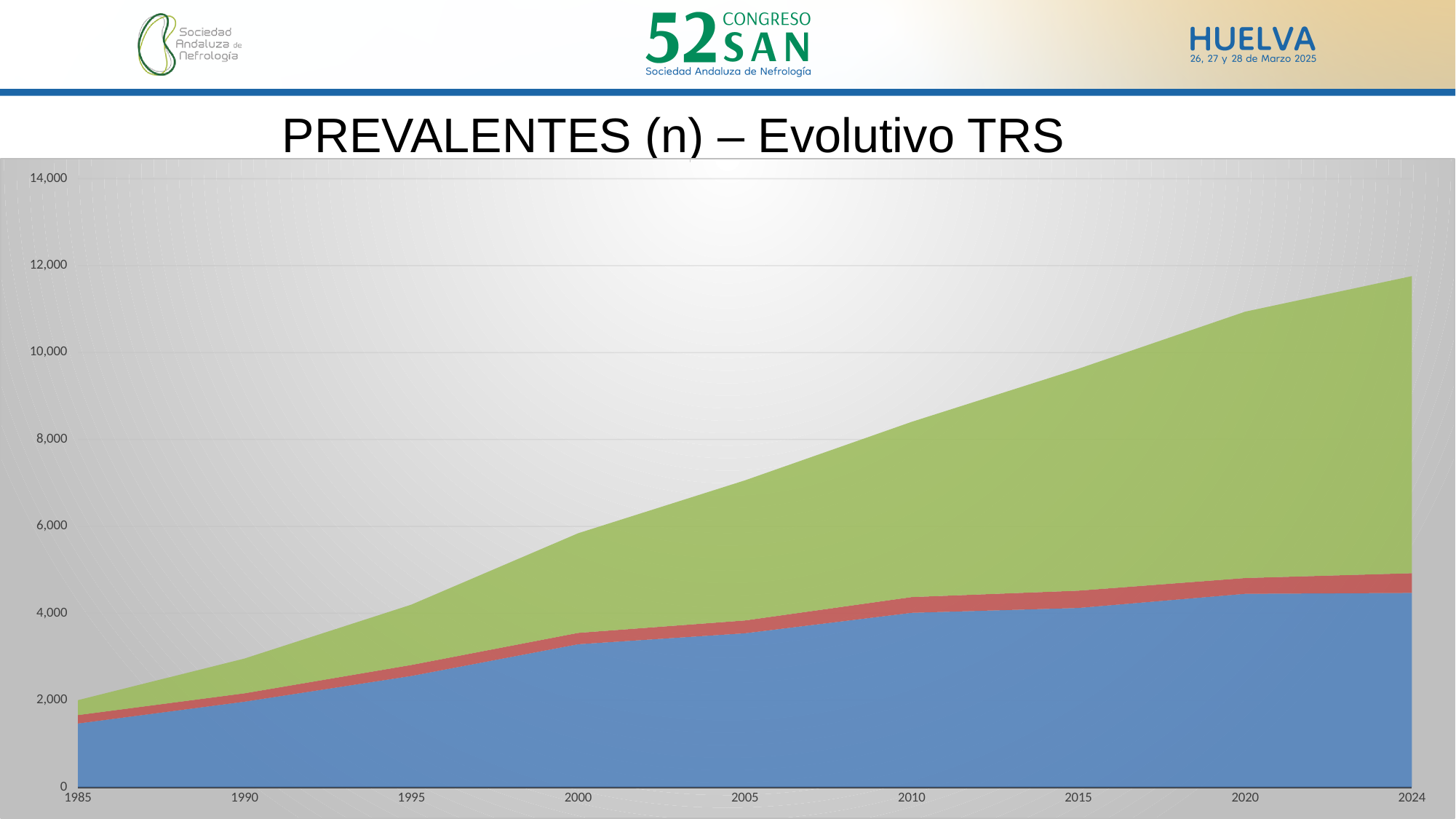
Which year has the lowest total stacked value? 1985 Which year has the highest total stacked value? 2024 What kind of chart is shown on the slide? Stacked area chart Is the value of the blue (bottom) series in 1985 greater or less than 2,000? less Is the total stacked value in 1985 greater or less than 4,000? less Does the total stacked value rise or fall from 1985 to 2024? Rise Is the total stacked value in 2005 greater or less than 6,000? greater What is the title of the chart? PREVALENTES (n) – Evolutivo TRS